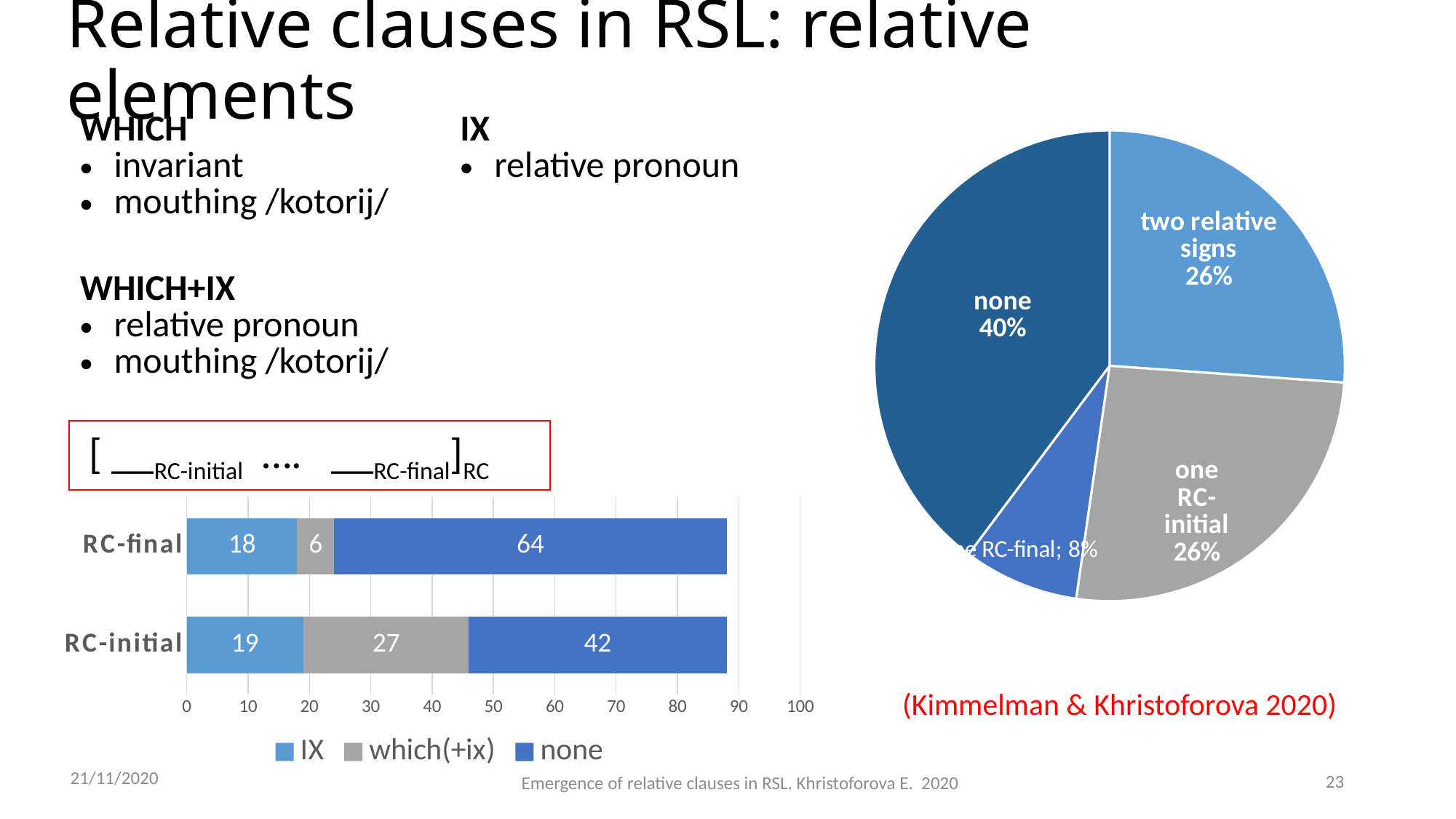
In the stacked bar chart at the bottom left, what is the value of the 'none' segment for RC-final? 64 How many slices does the pie chart on the right have? 4 In the pie chart on the right, what share does the 'two relative signs' slice have? 26% In the stacked bar chart at the bottom left, which category has the larger 'which(+ix)' value, RC-final or RC-initial? RC-initial In the stacked bar chart at the bottom left, what is the value of the 'which(+ix)' segment for RC-initial? 27 In the stacked bar chart at the bottom left, what is the value of the 'IX' segment for RC-final? 18 In the pie chart on the right, what share does the 'none' slice have? 40% How many series does the legend of the stacked bar chart at the bottom left list? 3 In the stacked bar chart at the bottom left, what is the total of the RC-initial bar? 88 What kind of chart is shown at the bottom left of the slide? Stacked bar chart In the pie chart on the right, which slice is the largest? none In the stacked bar chart at the bottom left, what is the difference between the 'none' values for RC-final and RC-initial? 22